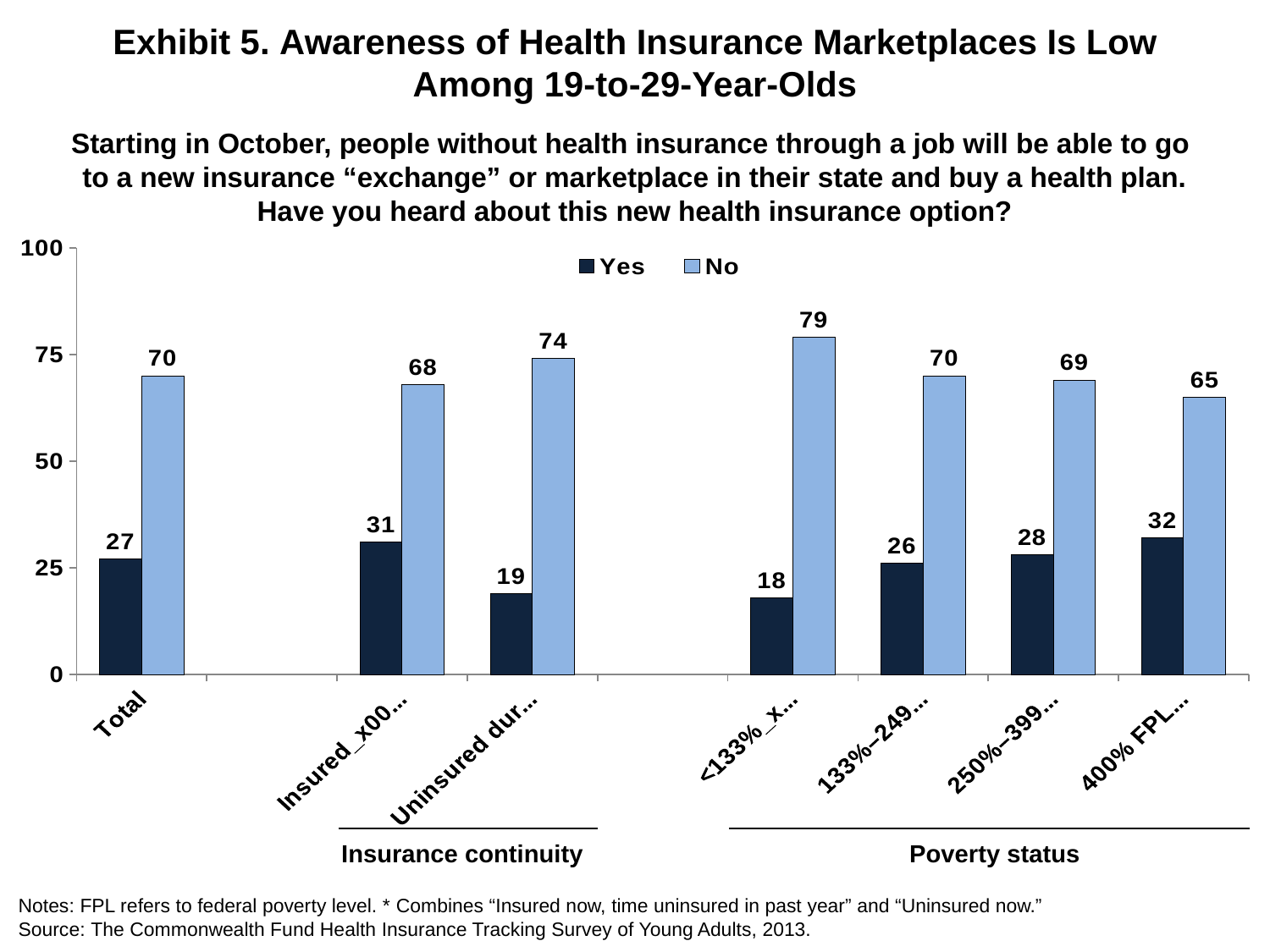
What is the lowest value among the Yes bars? 18 How many series does the legend list? 2 What is the highest value among the Yes bars? 32 What is the value of the No bar for Total? 70 How many categories are plotted along the x axis? 7 What is the highest value among the No bars? 79 What is the value of the Yes bar for Total? 27 What kind of chart is shown on the slide? Bar chart Is the Yes value for Total greater or less than 50? less For Total, which is larger, the Yes bar or the No bar? No What are the two entries in the legend? Yes and No What is the difference between the No and Yes values for Total? 43